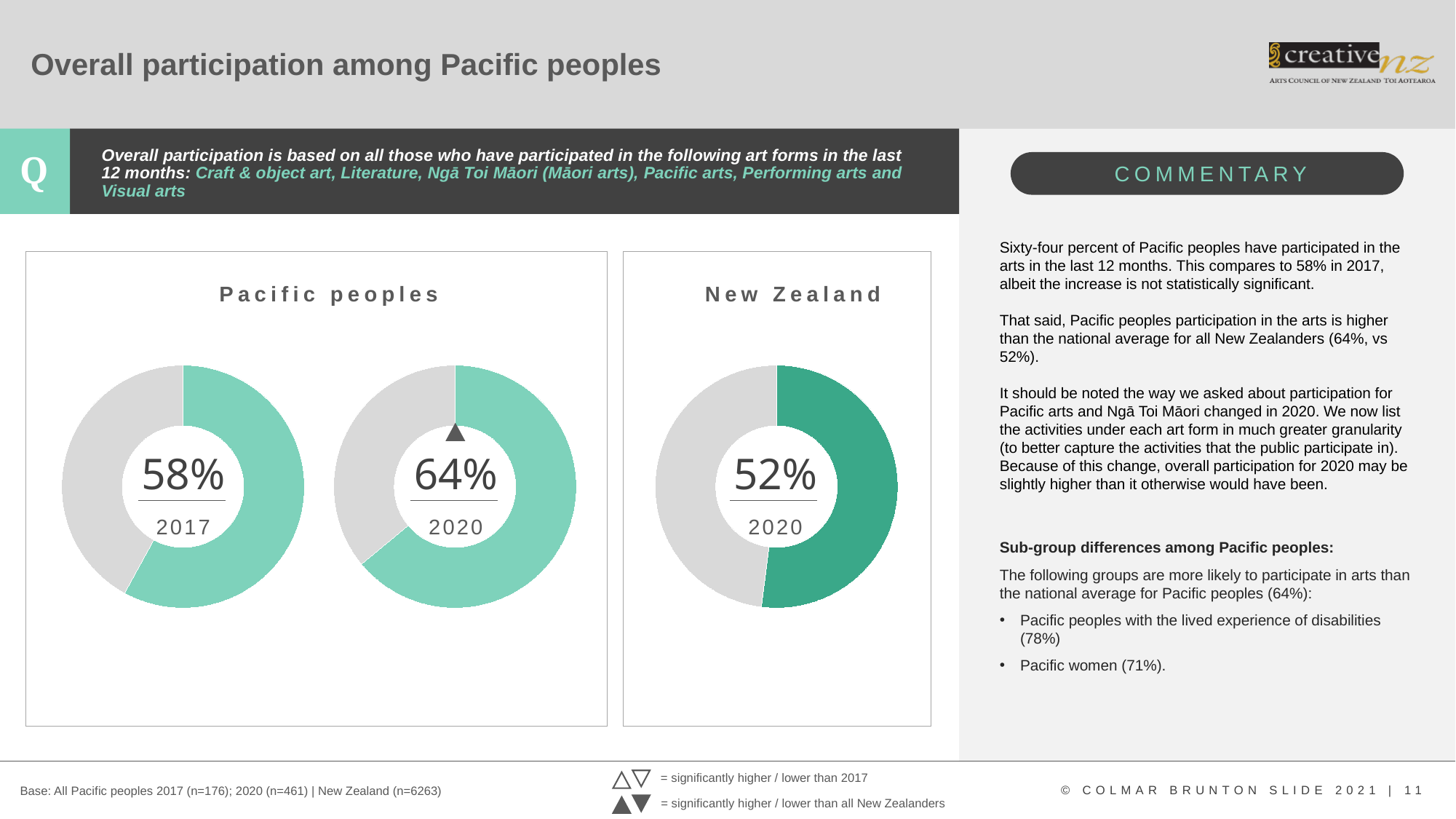
Across the three donut charts, which one shows the highest participation value? Pacific peoples 2020 (64%) In the Pacific peoples panel, did participation rise or fall from 2017 to 2020? Rise How many donut charts are shown on the slide? 3 In the New Zealand panel, what is the participation value shown for 2020? 52% In the Pacific peoples panel, what is the participation value shown for 2020? 64% Across the three donut charts, which one shows the lowest participation value? New Zealand 2020 (52%) What is the title of the panel containing the two donut charts on the left? Pacific peoples Which is larger: the Pacific peoples 2020 value or the New Zealand 2020 value? Pacific peoples 2020 What is the difference between the Pacific peoples 2020 value and the New Zealand 2020 value? 12 percentage points In the Pacific peoples panel, what is the participation value shown for 2017? 58% What kind of chart is used to show the participation values on this slide? Donut (pie) chart In the Pacific peoples panel, by how many percentage points did participation change from 2017 to 2020? 6 percentage points